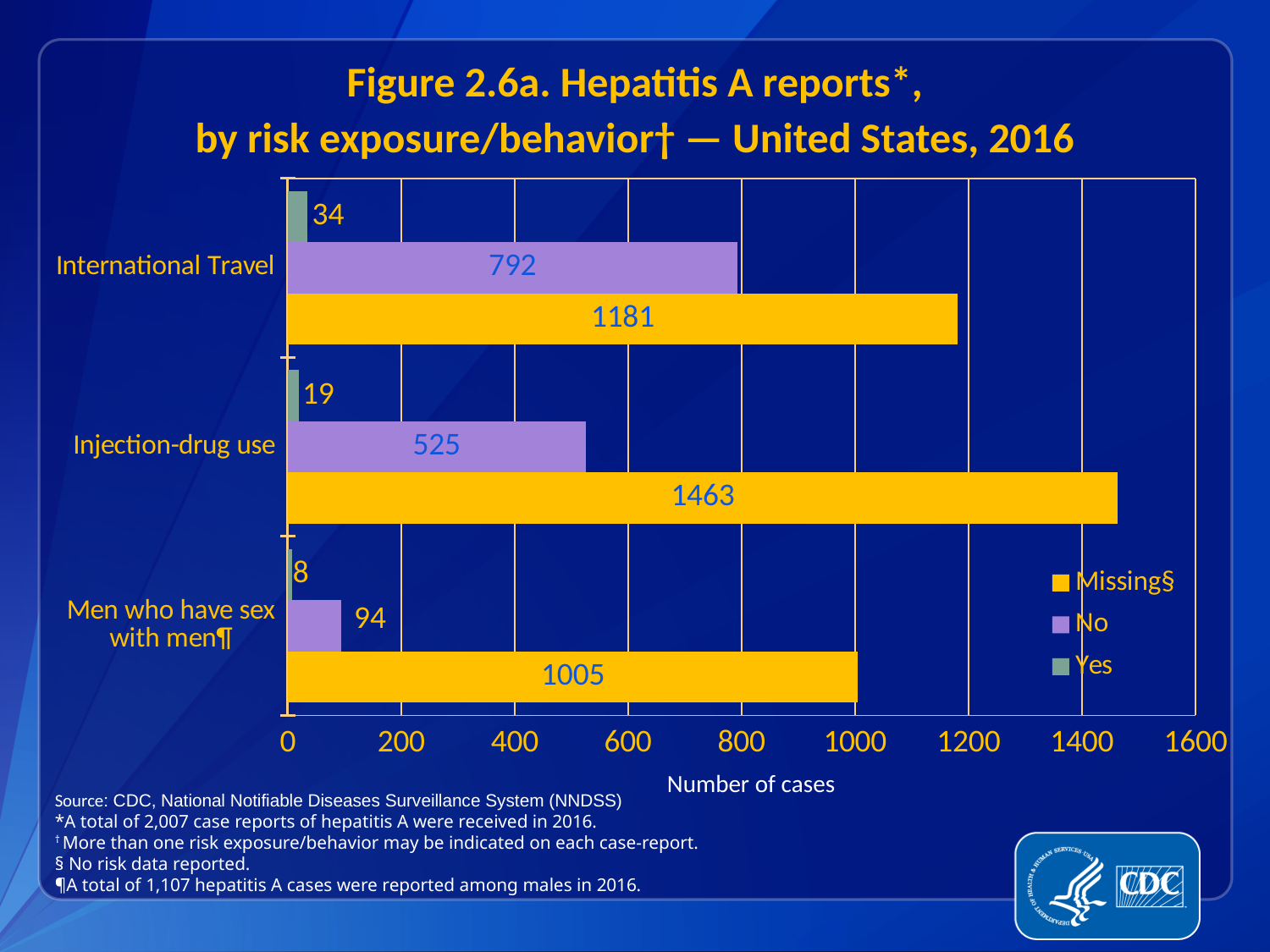
What is the number of cases with 'Missing' for Men who have sex with men? 1005 What is the number of cases with 'No' for Injection-drug use? 525 What kind of chart is shown on the slide? Bar chart Which risk exposure/behavior category has the lowest 'Yes' value? Men who have sex with men What is the number of cases with 'Yes' for International Travel? 34 What is the difference between the 'No' values for International Travel and Injection-drug use? 267 Which is larger: the 'Missing' value for International Travel or the 'Missing' value for Men who have sex with men? International Travel How many risk exposure/behavior categories are shown on the chart? 3 Which risk exposure/behavior category has the highest 'Missing' value? Injection-drug use Which colour represents the 'No' series in the legend? Purple What is the label of the x axis? Number of cases How many series does the legend list? 3